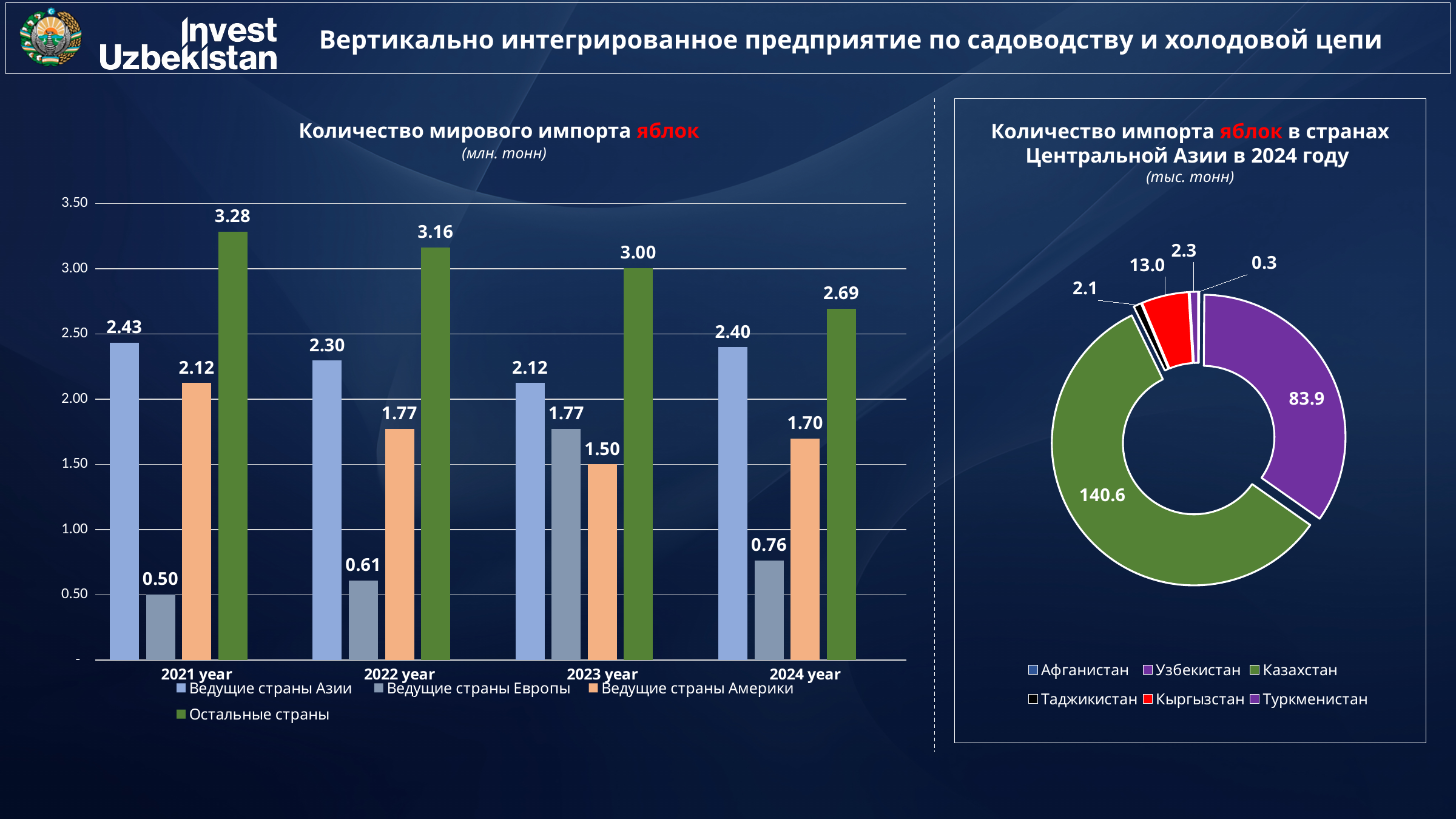
In the chart 'Количество мирового импорта яблок', what is the difference between Остальные страны in 2021 year and in 2024 year? 0.59 In the chart 'Количество мирового импорта яблок', what is the value for Ведущие страны Европы in 2023 year? 1.77 In the chart 'Количество мирового импорта яблок', what is the value for Остальные страны in 2021 year? 3.28 In the chart 'Количество импорта яблок в странах Центральной Азии в 2024 году', what is the value for Казахстан? 140.6 In the chart 'Количество импорта яблок в странах Центральной Азии в 2024 году', which is larger: Узбекистан or Кыргызстан? Узбекистан In the chart 'Количество мирового импорта яблок', what is the value for Ведущие страны Америки in 2024 year? 1.70 In the chart 'Количество мирового импорта яблок', does the value for Остальные страны rise or fall from 2021 year to 2024 year? fall In the chart 'Количество мирового импорта яблок', how many series does the legend list? 4 In the chart 'Количество мирового импорта яблок', which year has the lowest value for Ведущие страны Европы? 2021 year In the chart 'Количество мирового импорта яблок', which year has the highest value for Ведущие страны Азии? 2021 year What kind of chart is 'Количество импорта яблок в странах Центральной Азии в 2024 году'? doughnut chart In the chart 'Количество мирового импорта яблок', which is larger in 2022 year: Ведущие страны Азии or Ведущие страны Америки? Ведущие страны Азии